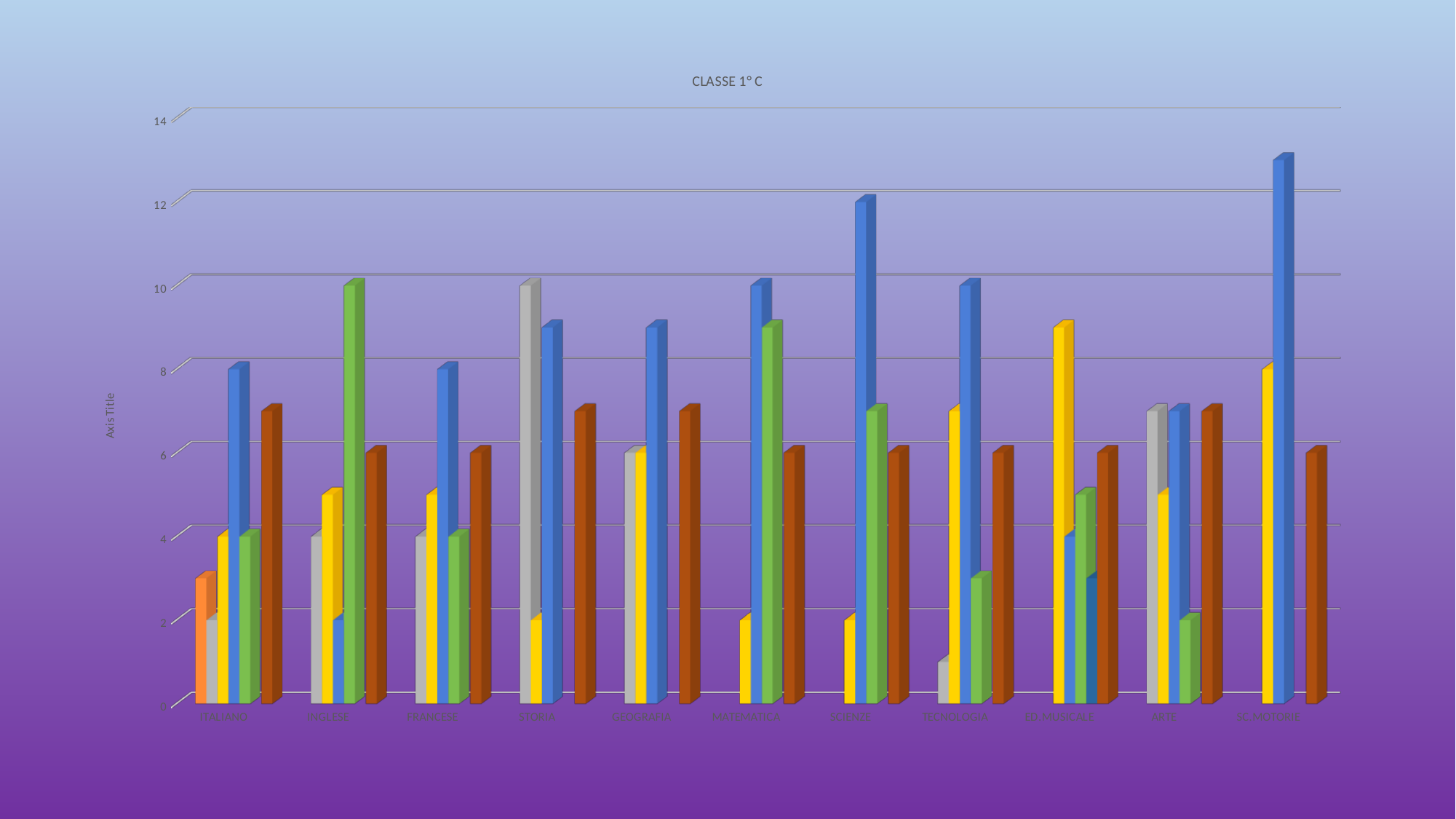
What is the title of the chart? CLASSE 1° C Is the value of the yellow bar for ED.MUSICALE greater or less than 8? greater Which is larger: the blue bar for SC.MOTORIE or the blue bar for ITALIANO? SC.MOTORIE What kind of chart is shown on the slide? bar chart Is the value of the green bar for INGLESE greater or less than 8? greater What is the highest value shown on the vertical axis of the chart? 14 Which category contains the tallest bar in the chart? SC.MOTORIE How many categories are shown along the x axis of the chart? 11 Is the value of the gray bar for TECNOLOGIA greater or less than 2? less